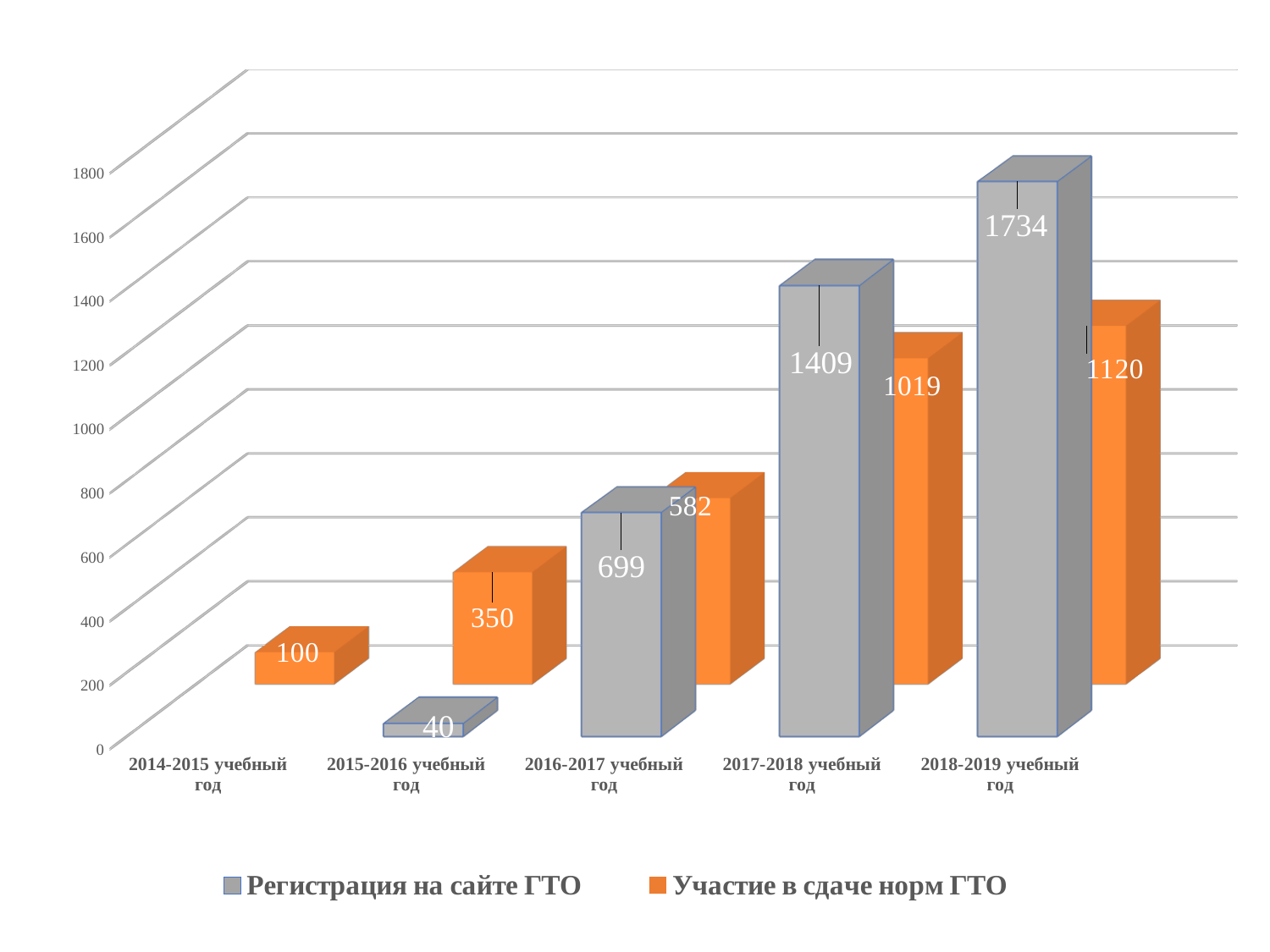
Does the value for Регистрация на сайте ГТО rise or fall from 2015-2016 to 2018-2019 учебный год? rise Which academic year has the lowest value for Участие в сдаче норм ГТО? 2014-2015 учебный год What is the difference between Регистрация на сайте ГТО and Участие в сдаче норм ГТО in 2018-2019 учебный год? 614 What is the value for Регистрация на сайте ГТО in 2018-2019 учебный год? 1734 How many academic years are shown on the x axis? 5 In 2016-2017 учебный год, which is larger: Регистрация на сайте ГТО or Участие в сдаче норм ГТО? Регистрация на сайте ГТО What is the value for Участие в сдаче норм ГТО in 2017-2018 учебный год? 1019 Which academic year has the highest value for Регистрация на сайте ГТО? 2018-2019 учебный год What is the value for Регистрация на сайте ГТО in 2015-2016 учебный год? 40 Which colour represents Участие в сдаче норм ГТО in the legend? orange How many series does the legend list? 2 What kind of chart is shown on the slide? bar chart